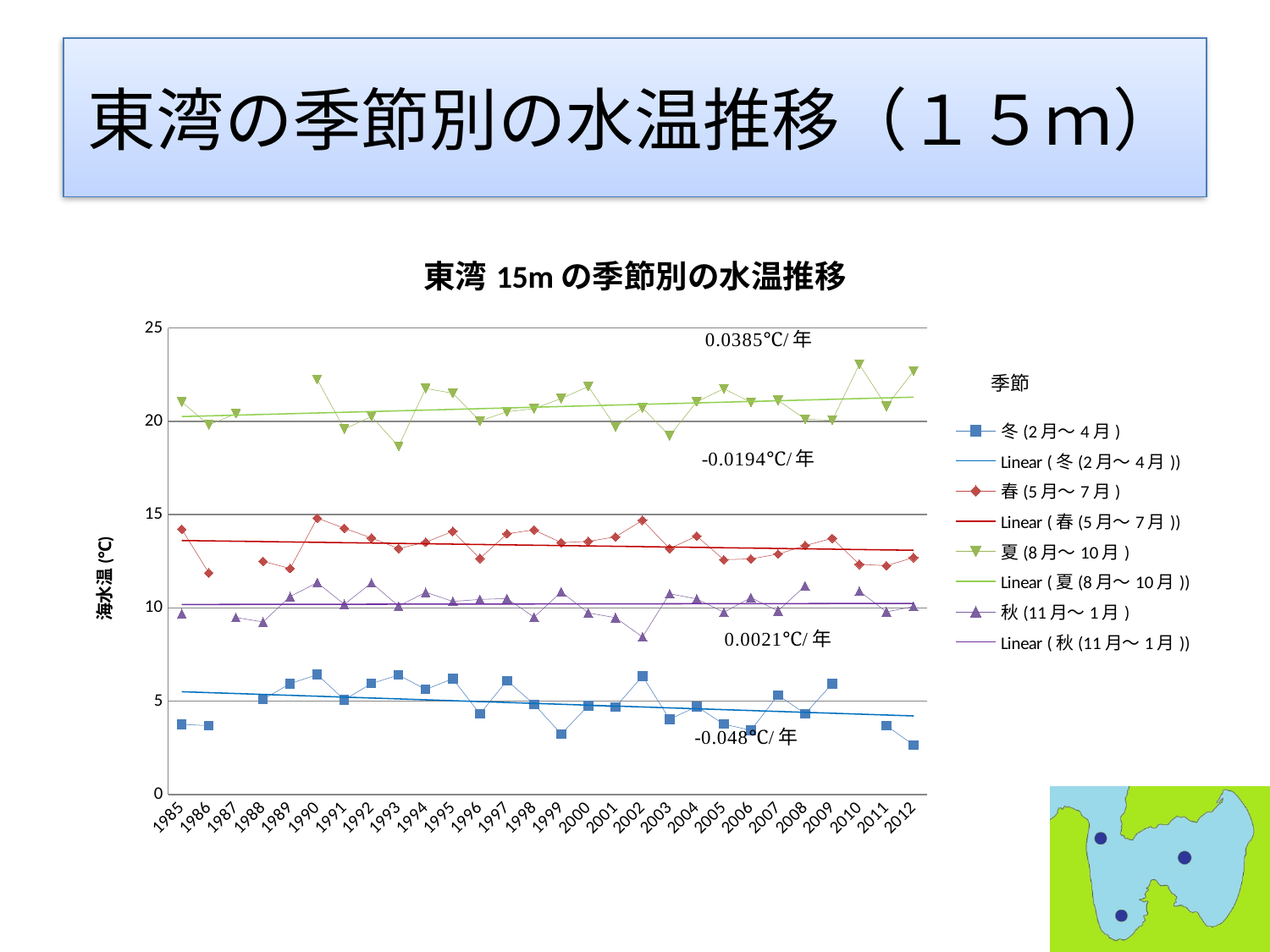
What is the title of the chart? 東湾 15m の季節別の水温推移 What kind of chart is shown on the slide? line chart Is the value for 冬 (2月～4月) in 2012 greater or less than 5? less How many years are shown along the x axis of the chart? 28 Is the value for 夏 (8月～10月) in 1993 greater or less than 20? less What is the label on the vertical axis of the chart? 海水温 (℃) Which season's series has the lowest water temperatures throughout the chart? 冬 (2月～4月) Is the value for 秋 (11月～1月) in 2002 greater or less than 10? less Which season's series has the highest water temperatures throughout the chart? 夏 (8月～10月) In 1995, which is larger: the value for 春 (5月～7月) or the value for 秋 (11月～1月)? 春 (5月～7月) What trend rate is printed next to the 冬 (2月～4月) series on the chart? -0.048℃/年 How many entries does the chart's legend list? 8